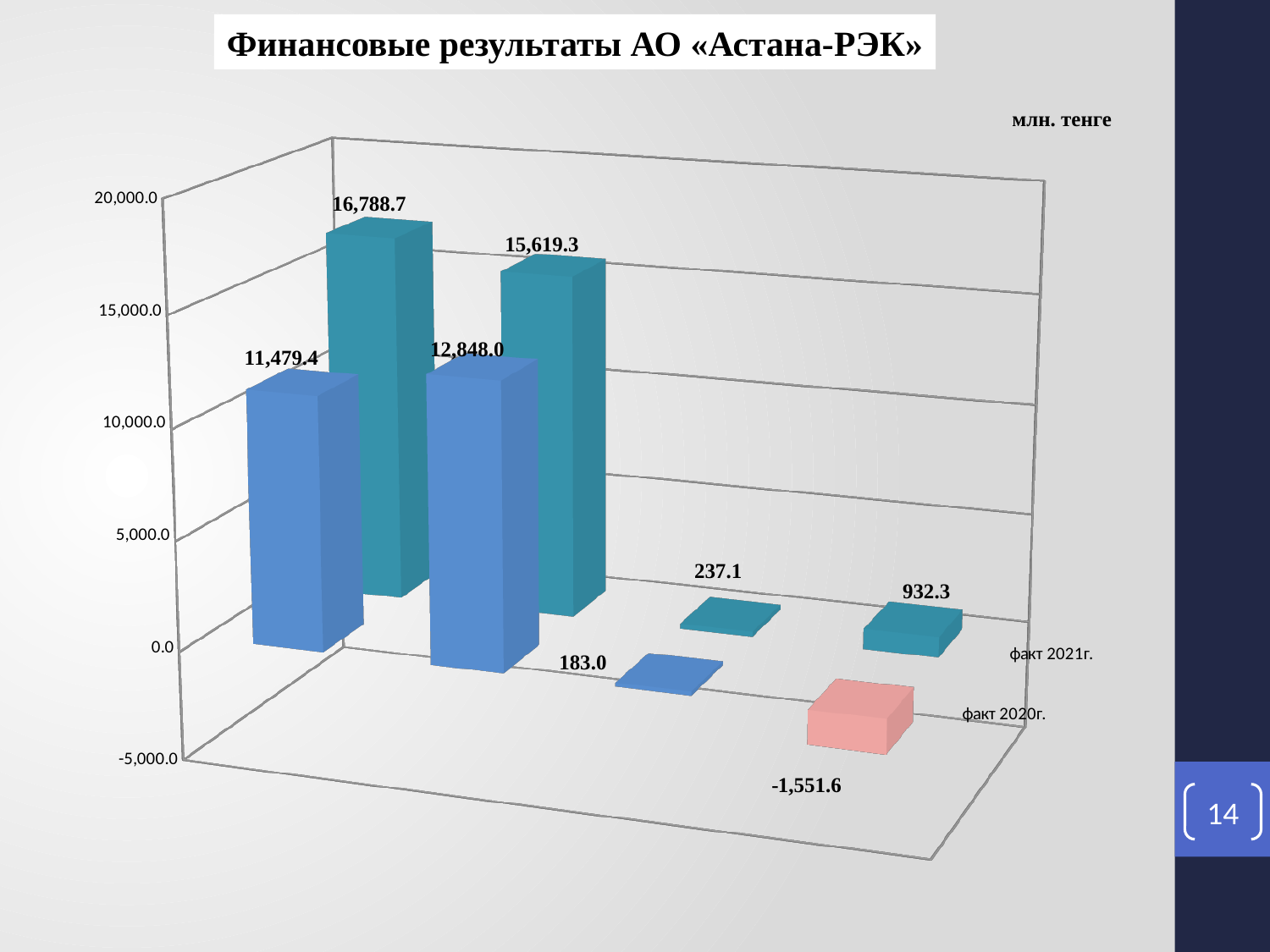
What is the value of the first bar in the факт 2020г. series? 11,479.4 What is the value of the fourth bar in the факт 2020г. series? -1,551.6 What is the lowest value shown in the chart? -1,551.6 Which is larger: the second bar of факт 2021г. (15,619.3) or the second bar of факт 2020г. (12,848.0)? факт 2021г. (15,619.3) What is the highest value shown in the chart? 16,788.7 What is the difference between the first bars of the факт 2021г. and факт 2020г. series (16,788.7 and 11,479.4)? 5,309.3 How many series are shown in the chart? 2 Is the value 932.3 in the факт 2021г. series greater or less than 5,000.0? less What kind of chart is shown on the slide? bar chart What is the value of the first bar in the факт 2021г. series? 16,788.7 What unit is indicated for the values in the chart? млн. тенге What is the title of the chart on the slide? Финансовые результаты АО «Астана-РЭК»